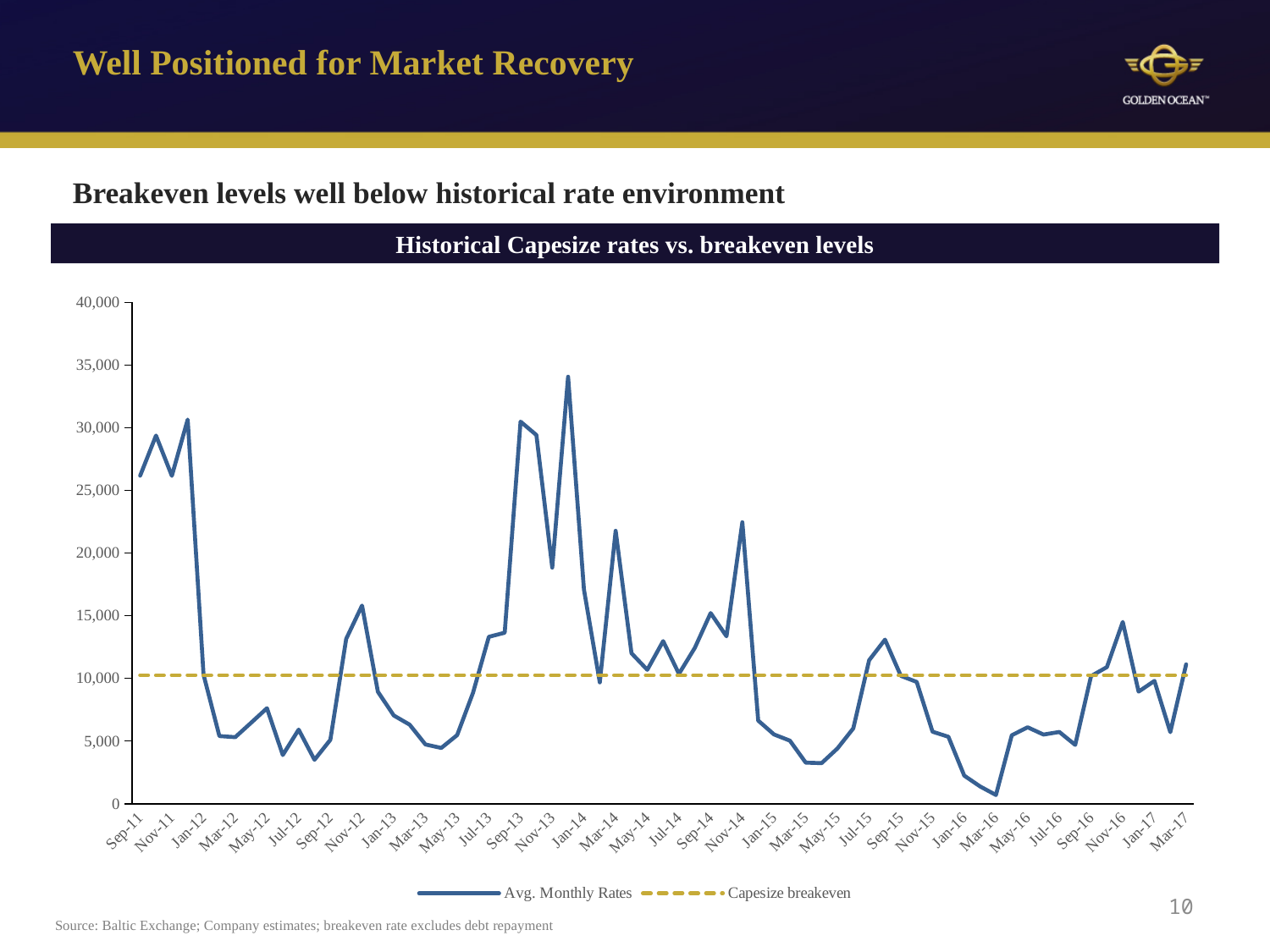
What is the title of the chart? Historical Capesize rates vs. breakeven levels How many series does the chart's legend list? 2 What kind of chart is shown on the slide? Line chart Is the Capesize breakeven level greater or less than 15,000? less Do Avg. Monthly Rates rise or fall between Sep-11 and Mar-12? fall Is the lowest value of Avg. Monthly Rates greater or less than 5,000? less Do Avg. Monthly Rates rise or fall between Jul-13 and Sep-13? rise Which is larger, the Avg. Monthly Rates value for Sep-13 or for Mar-15? Sep-13 Is the Avg. Monthly Rates value for Mar-15 greater or less than 10,000? less Which series is drawn as a dashed line in the chart? Capesize breakeven